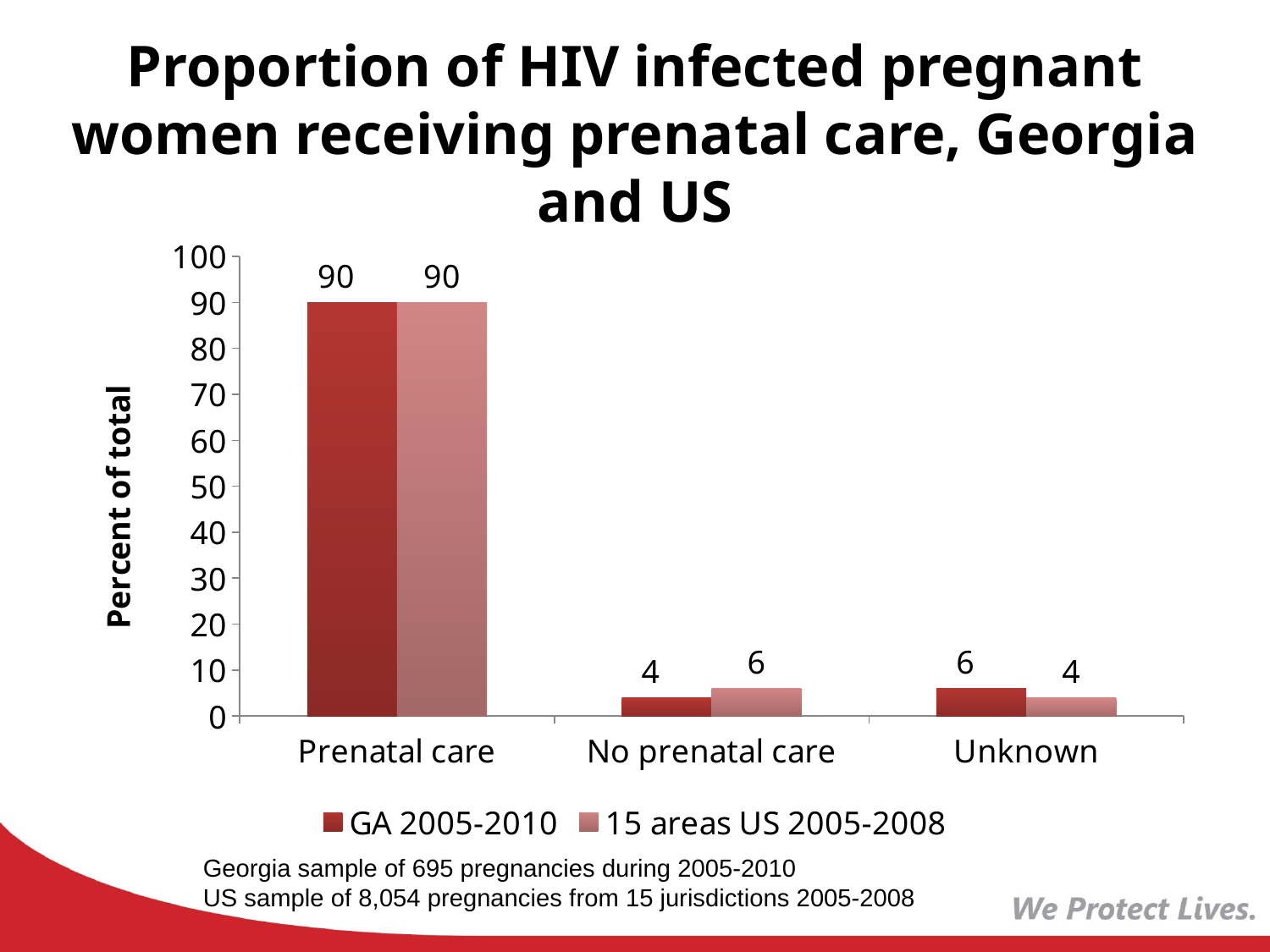
What is the value for 15 areas US 2005-2008 in the Unknown category? 4 Which category has the lowest value for 15 areas US 2005-2008? Unknown Which category has the highest value for GA 2005-2010? Prenatal care What is the value for GA 2005-2010 in the Unknown category? 6 What is the difference between the GA 2005-2010 and 15 areas US 2005-2008 values in the No prenatal care category? 2 What is the label of the y axis? Percent of total What is the value for GA 2005-2010 in the Prenatal care category? 90 How many series does the legend list? 2 How many categories are shown on the x axis? 3 What is the value for 15 areas US 2005-2008 in the No prenatal care category? 6 In the Unknown category, which series has the larger value, GA 2005-2010 or 15 areas US 2005-2008? GA 2005-2010 What kind of chart is shown on the slide? Bar chart